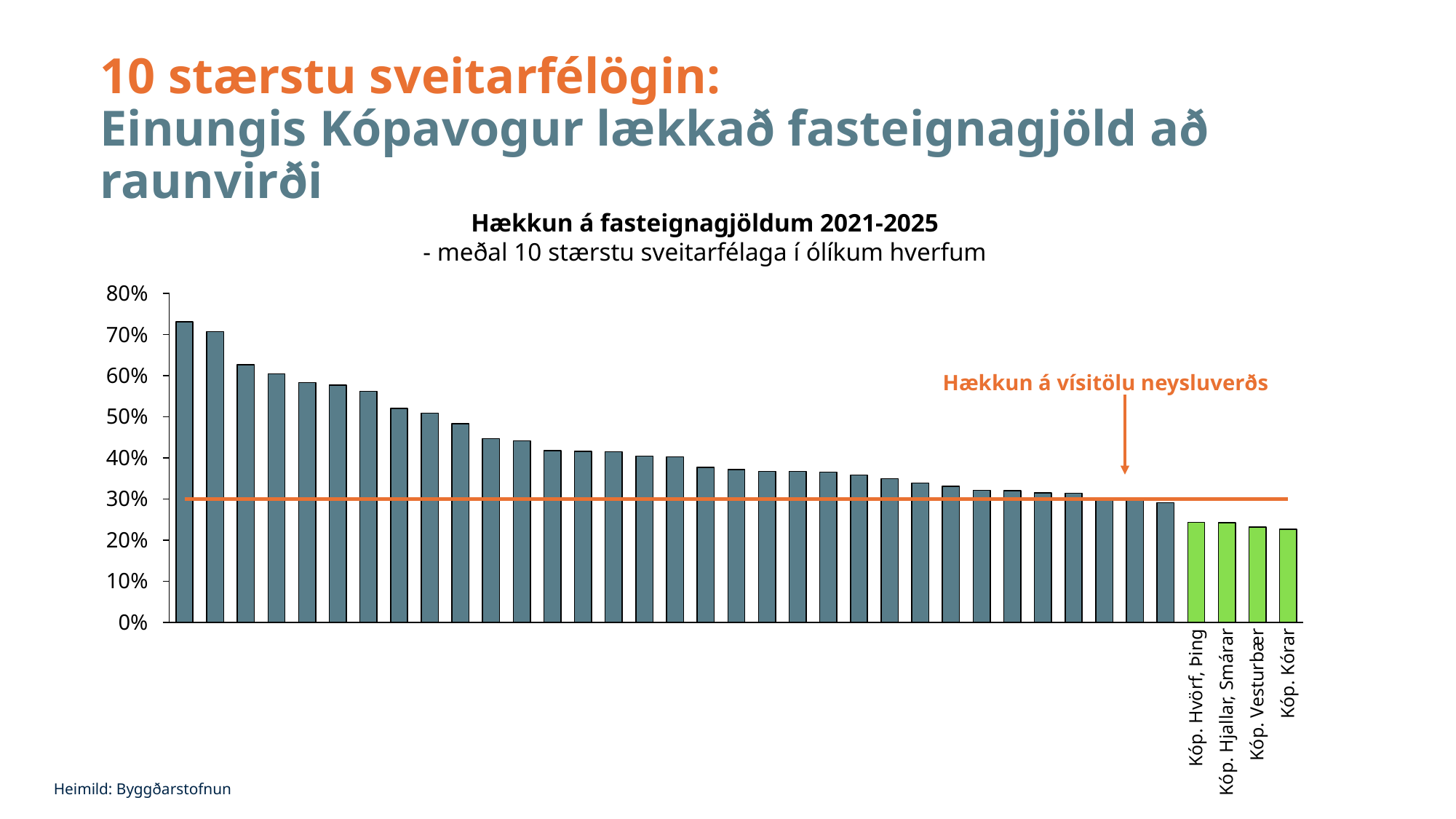
Do the bar values rise or fall from left to right along the x axis? fall Is the value for Kóp. Kórar greater or less than 30%? less Is the value for Kóp. Hjallar, Smárar greater or less than 30%? less What does the orange horizontal line on the chart represent? Hækkun á vísitölu neysluverðs What kind of chart is shown on the slide? bar chart Which is larger, the value for Kóp. Kórar or the value of the leftmost bar? the leftmost bar At what level on the y axis does the orange horizontal line sit? 30% Is the value for Kóp. Hvörf, Þing greater or less than 20%? greater How many bars are coloured green on the chart? 4 What is the title of the chart? Hækkun á fasteignagjöldum 2021-2025